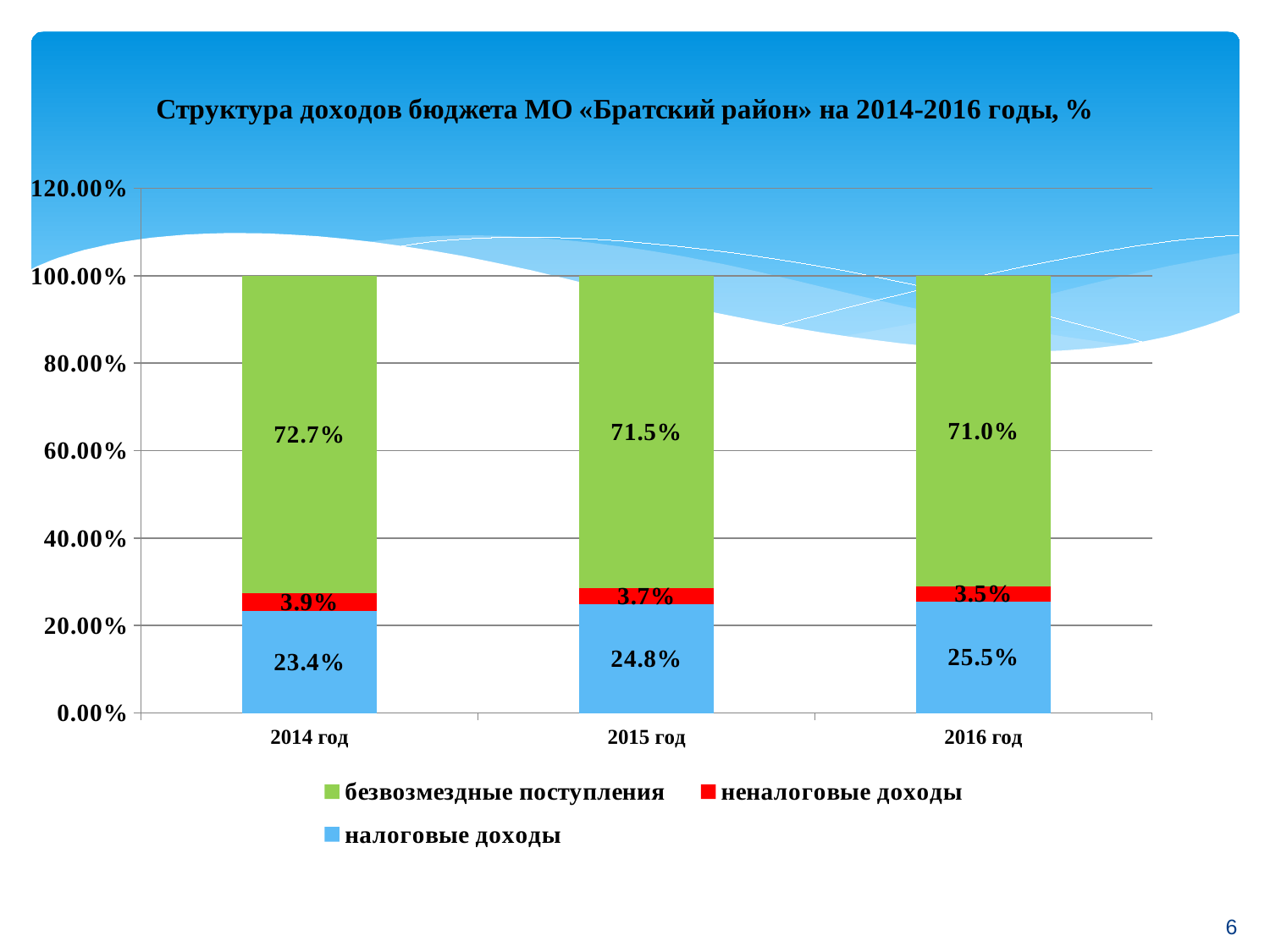
What kind of chart is shown on the slide? Stacked bar chart How many years are shown on the x axis? 3 Which year has the highest value for налоговые доходы? 2016 год What is the total of the stacked bar for 2015 год? 100.0% What is the difference between безвозмездные поступления in 2014 год and 2016 год? 1.7% Which is larger: налоговые доходы in 2015 год or in 2014 год? 2015 год What is the value for неналоговые доходы in 2015 год? 3.7% How many series does the legend list? 3 What is the value for налоговые доходы in 2016 год? 25.5% What is the value for безвозмездные поступления in 2014 год? 72.7% Do the values for неналоговые доходы rise or fall from 2014 год to 2016 год? Fall Which year has the lowest value for безвозмездные поступления? 2016 год